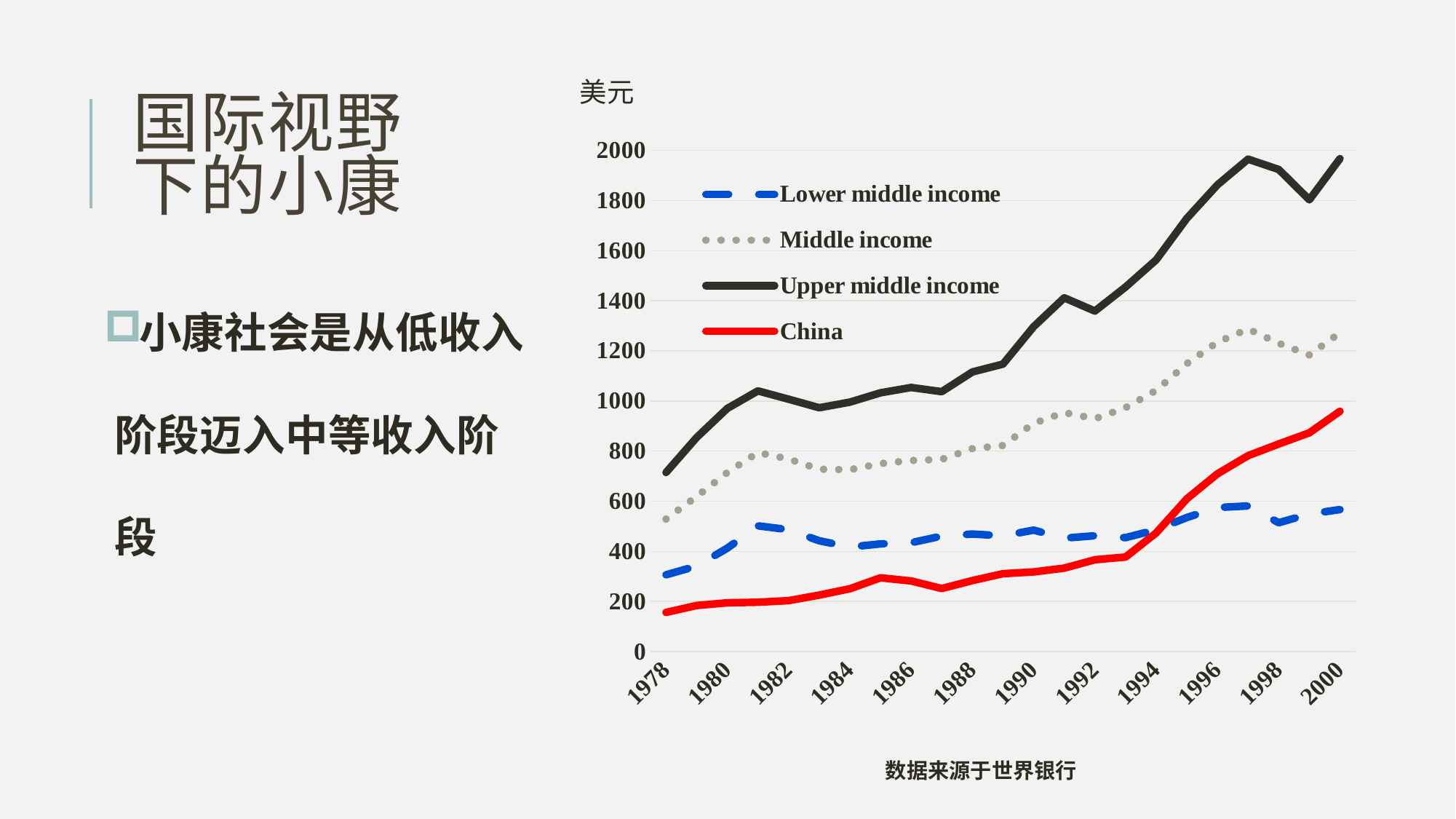
Which series is plotted with a red line? China Is the value for China in 1978 greater or less than 200? less What unit label is shown above the y axis? 美元 How many series does the legend list? 4 Which series has the highest value in 2000? Upper middle income Which series has the lowest value in 1978? China Is the value for China in 2000 greater or less than 800? greater How many year labels are shown on the x axis? 12 Is the value for Upper middle income in 2000 greater or less than 1800? greater In 2000, which is larger: the value for China or the value for Lower middle income? China Does the value for China rise or fall from 1978 to 2000? rise What kind of chart is shown on the slide? line chart